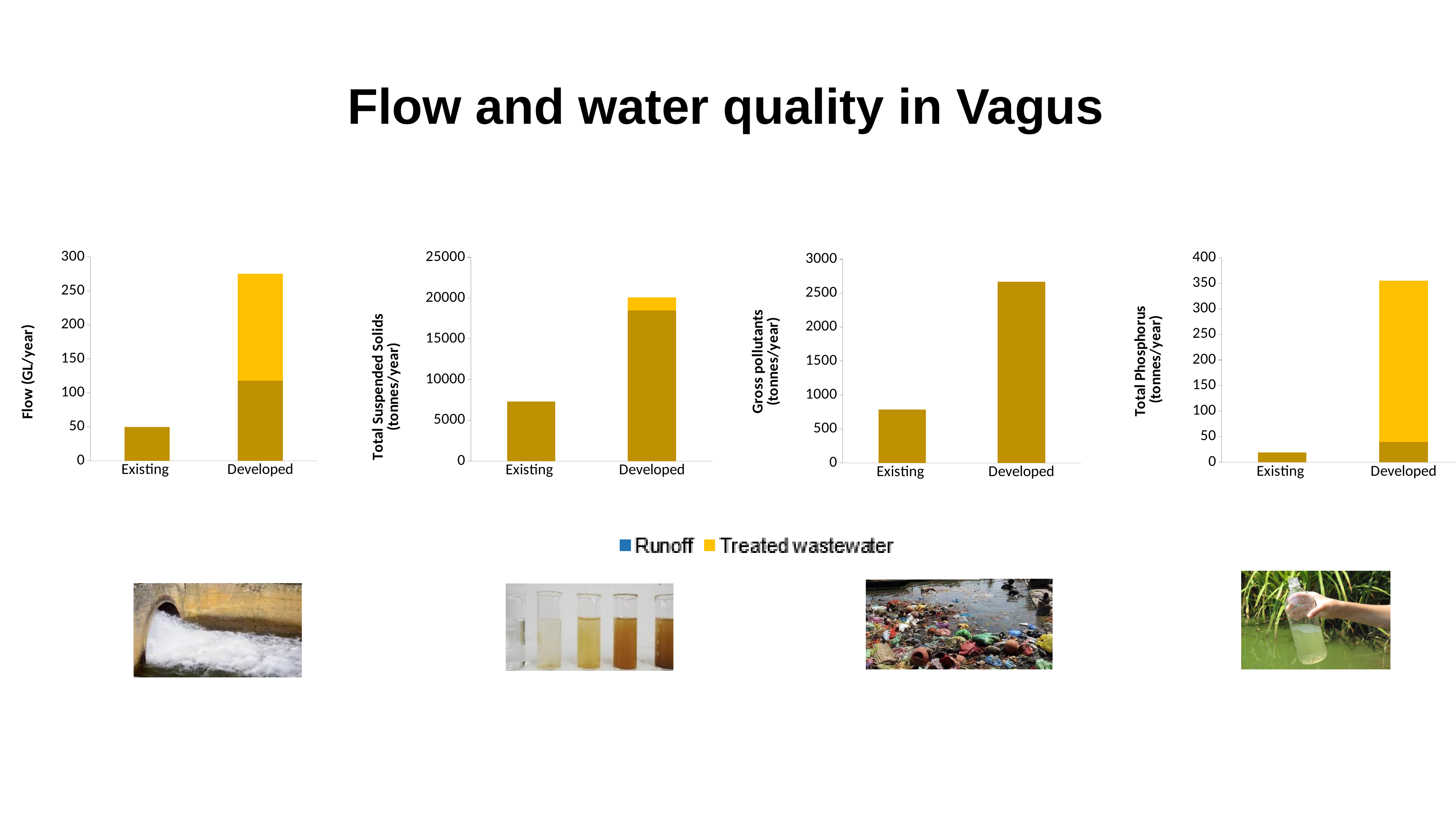
In the Flow (GL/year) chart, is the total value for Developed greater or less than 250? greater What kind of chart is the Flow (GL/year) chart? bar chart In the Flow (GL/year) chart, which category has the higher total, Existing or Developed? Developed How many series does the legend list? 2 In the Total Suspended Solids (tonnes/year) chart, is the total value for Developed greater or less than 15000? greater In the Total Suspended Solids (tonnes/year) chart, is the value for Existing greater or less than 10000? less In the Total Phosphorus (tonnes/year) chart, which category has the higher total, Existing or Developed? Developed How many categories are shown on the x axis of the Gross pollutants (tonnes/year) chart? 2 What are the two series named in the legend? Runoff and Treated wastewater